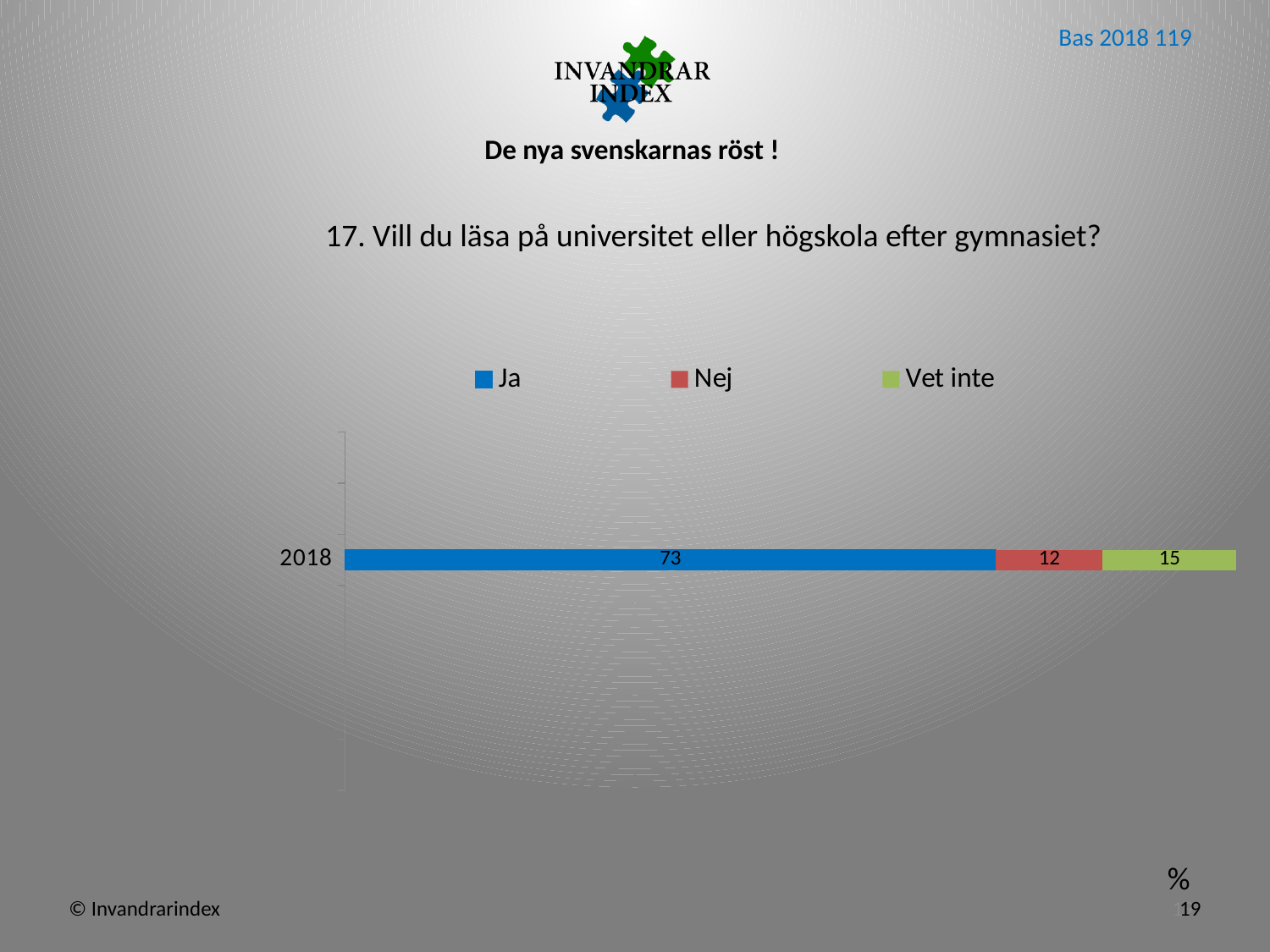
What is the value for "Vet inte" in 2018? 15 Which response has the lowest value in 2018? Nej What colour represents "Ja" in the chart? Blue What is the difference between the values for "Vet inte" and "Nej" in 2018? 3 What is the value for "Nej" in 2018? 12 Which is larger in 2018, "Vet inte" or "Nej"? Vet inte Which response has the highest value in 2018? Ja What is the value for "Ja" in 2018? 73 How many series does the legend list? 3 What kind of chart is shown on the slide? Stacked bar chart What is the total of the stacked bar for 2018? 100 What is the difference between the values for "Ja" and "Nej" in 2018? 61